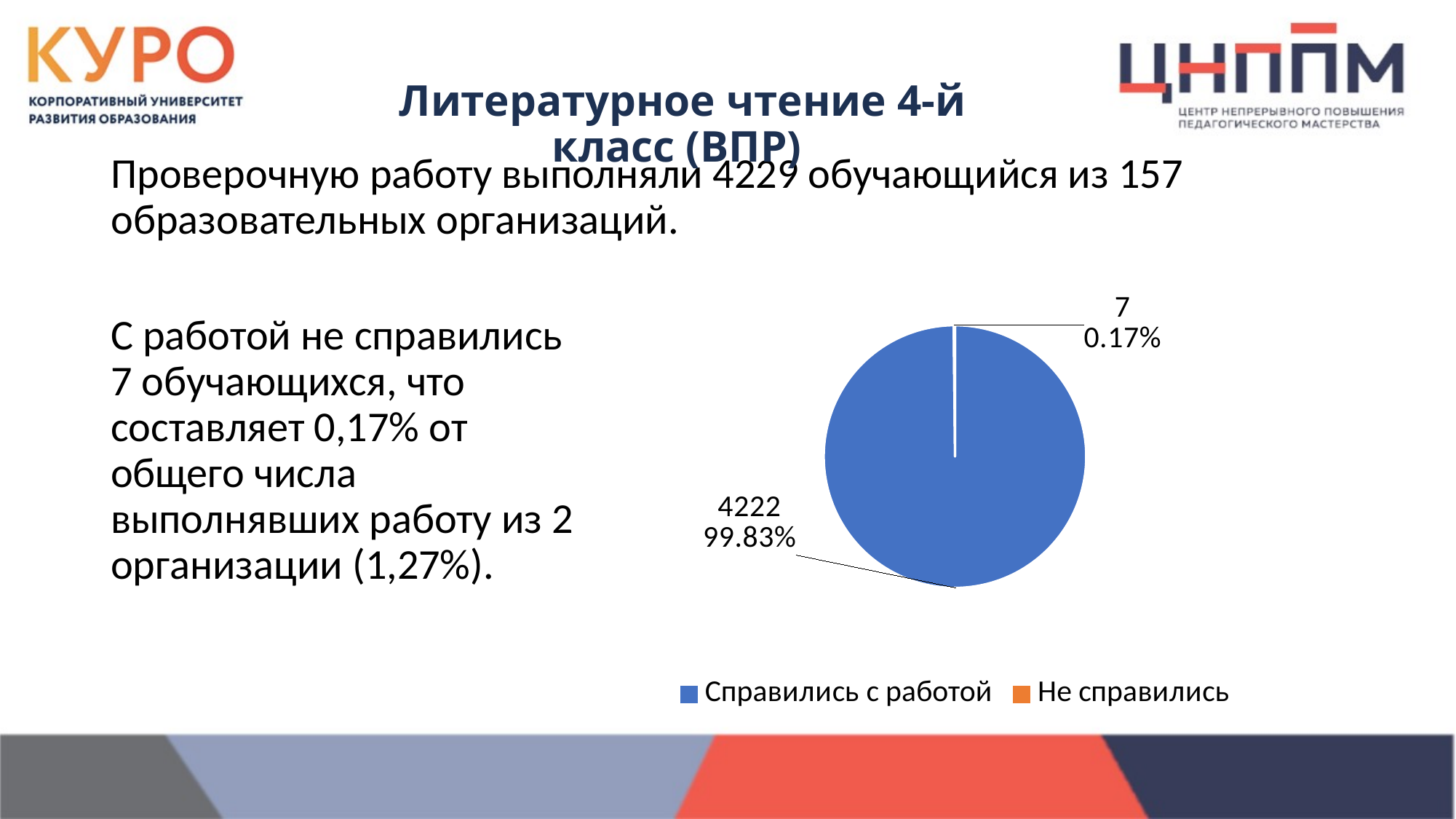
What kind of chart is shown on the slide? pie chart How many series does the chart legend list? 2 What colour is the 'Справились с работой' slice in the pie chart? blue What is the value for 'Не справились' in the pie chart? 7 What is the value for 'Справились с работой' in the pie chart? 4222 Which slice of the pie chart is the largest? Справились с работой What share of the pie does 'Не справились' represent? 0.17% What is the total of the two values shown in the pie chart? 4229 Which is larger: the value for 'Справились с работой' or 'Не справились'? Справились с работой What share of the pie does 'Справились с работой' represent? 99.83% What is the difference between the values for 'Справились с работой' and 'Не справились'? 4215 Which slice of the pie chart is the smallest? Не справились